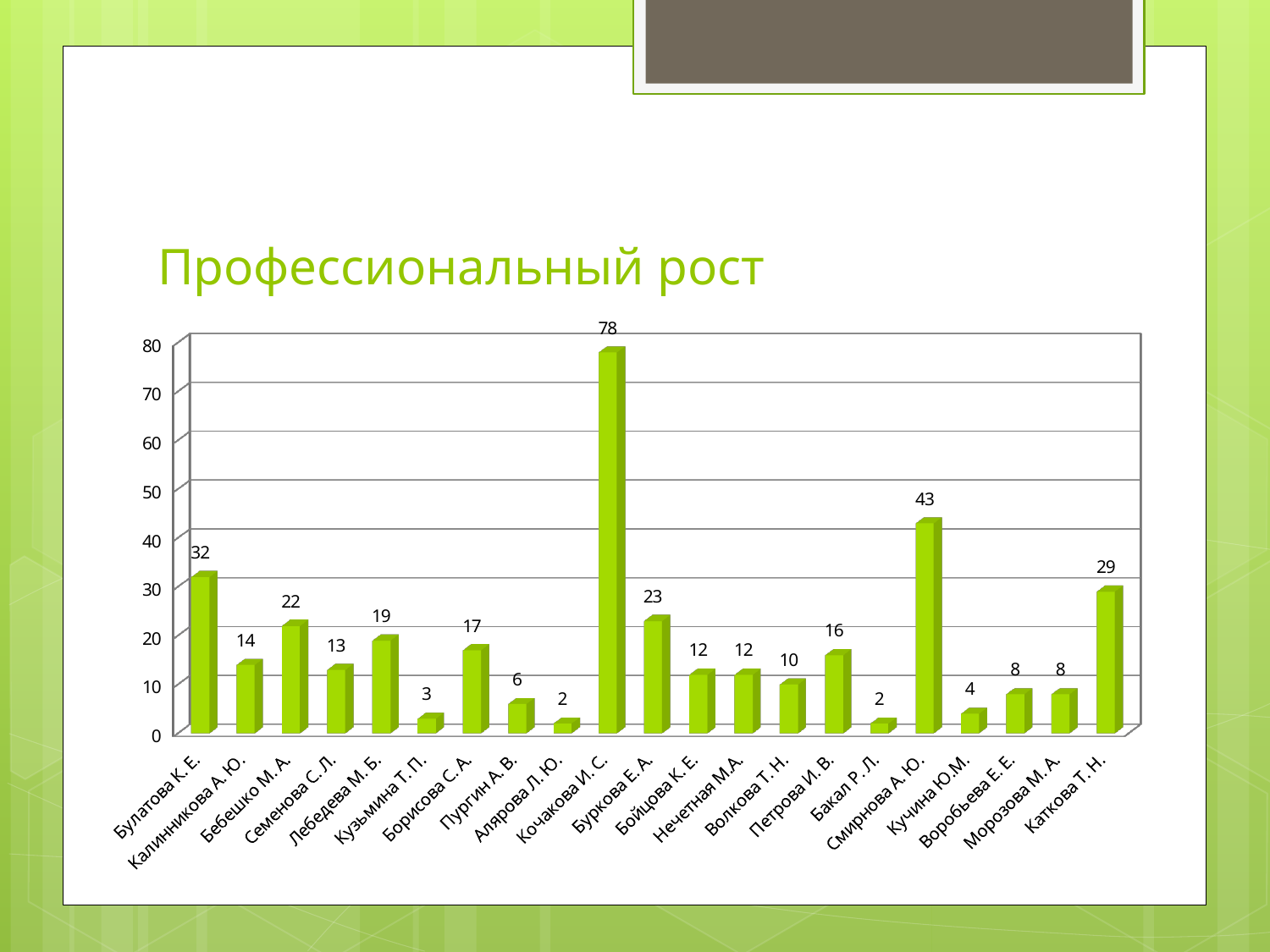
What is the difference between the values for Кочакова И. С. and Смирнова А. Ю.? 35 What kind of chart is shown on the slide? bar chart What is the value for Булатова К. Е.? 32 What is the value for Смирнова А. Ю.? 43 Which category has the highest value? Кочакова И. С. What is the value for Кузьмина Т. П.? 3 How many categories are shown on the x axis? 21 What is the value for Кочакова И. С.? 78 Which is larger, the value for Бебешко М. А. or the value for Лебедева М. Б.? Бебешко М. А. What is the title of the slide? Профессиональный рост Which is larger, the value for Петрова И. В. or the value for Волкова Т. Н.? Петрова И. В. What is the difference between the values for Каткова Т. Н. and Буркова Е. А.? 6